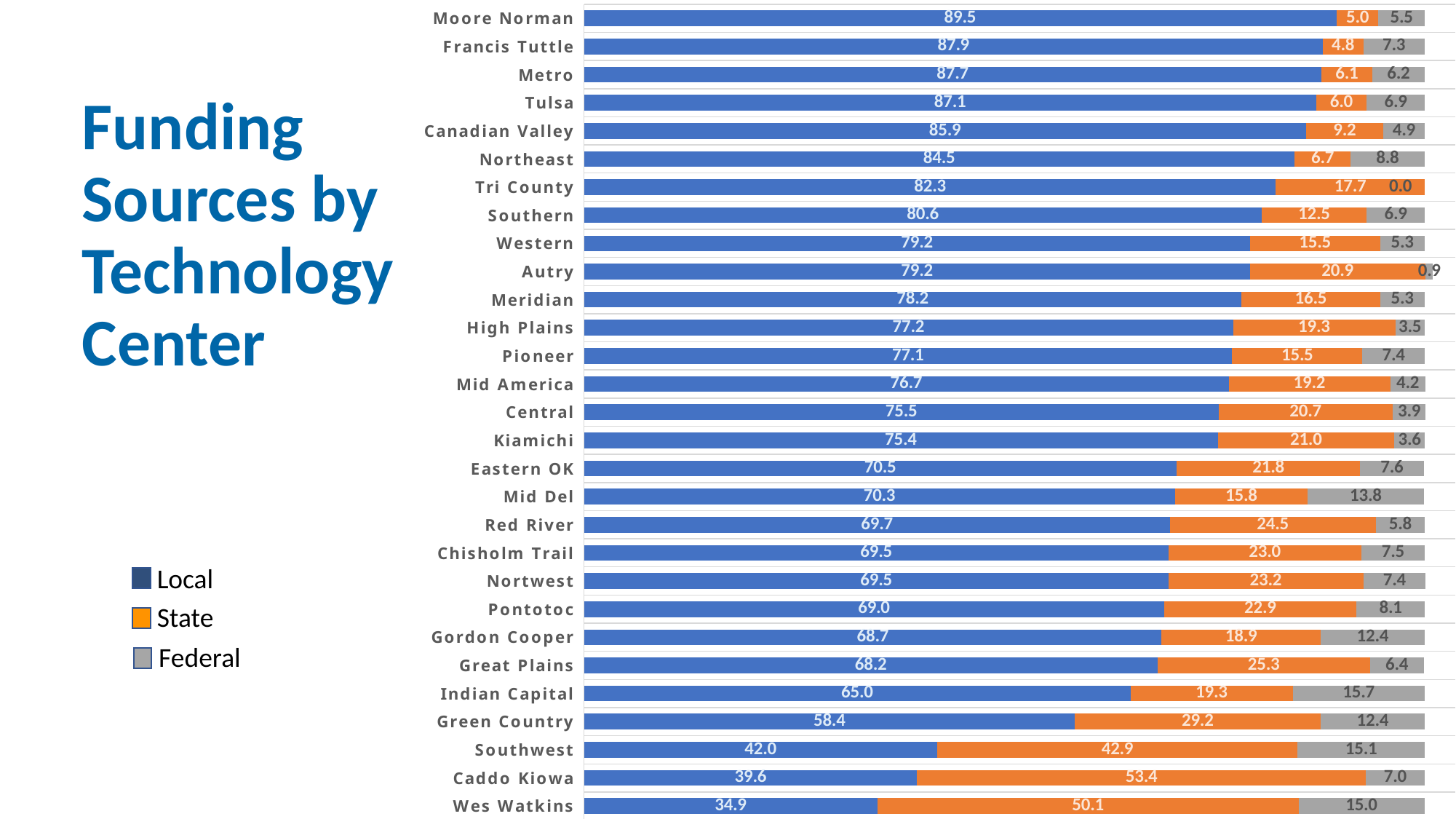
Which technology center has the highest Local value? Moore Norman What is the Local value for Moore Norman? 89.5 What is the State value for Caddo Kiowa? 53.4 What is the Federal value for Mid Del? 13.8 Which technology center has the highest State value? Caddo Kiowa What is the difference between the Local values for Southwest and Wes Watkins? 7.1 Which technology center has the highest Federal value? Indian Capital Which technology center has the lowest Local value? Wes Watkins What kind of chart is shown on the slide? Stacked bar chart Which is larger, the State value for Green Country or the State value for Great Plains? Green Country How many technology centers are shown in the chart? 29 How many series does the legend list? 3